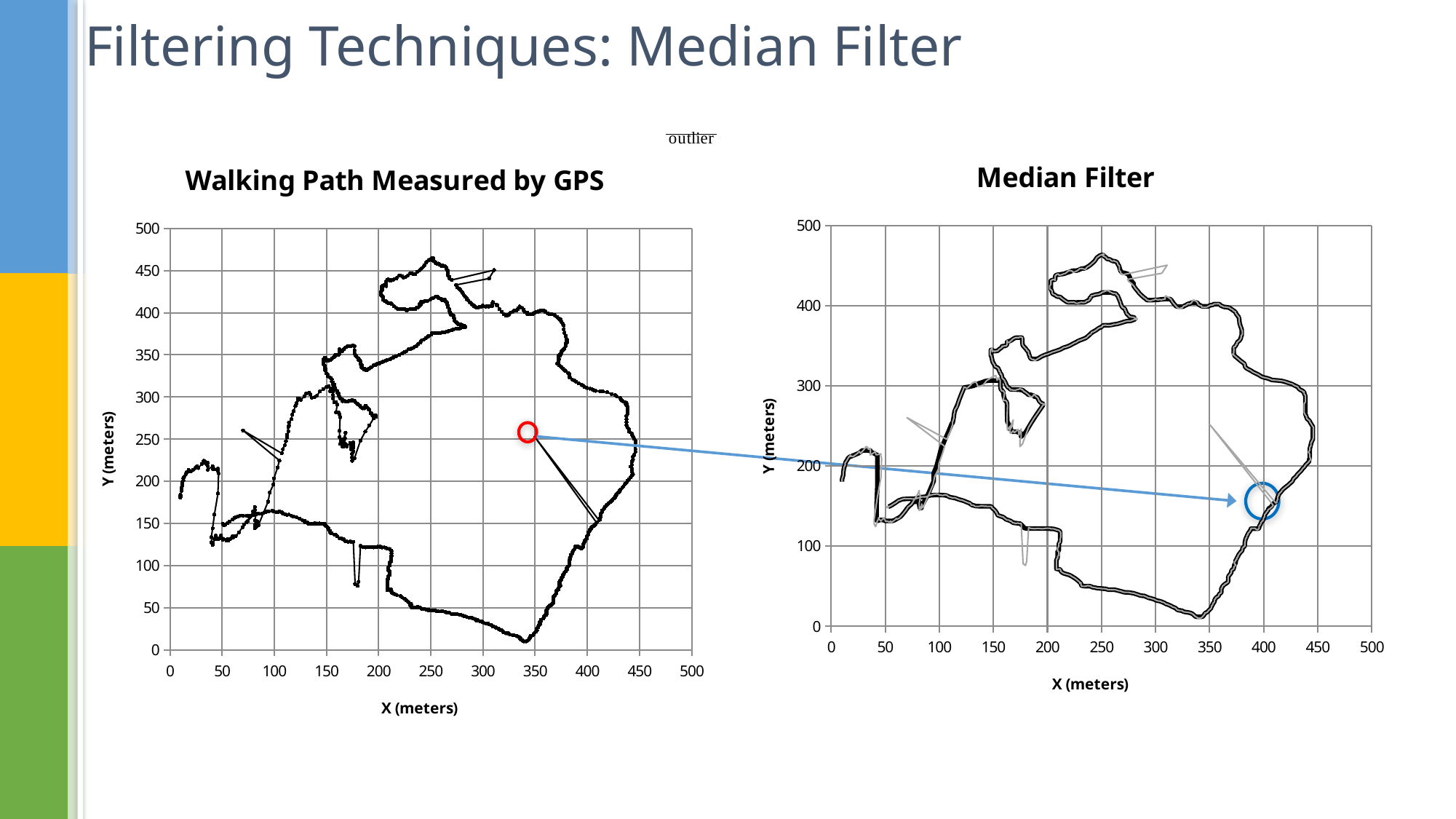
In the 'Walking Path Measured by GPS' chart, is the Y value of the downward spike near X = 180 greater or less than 100? less In the 'Walking Path Measured by GPS' chart, is the lowest Y value reached by the path (near X = 340) greater or less than 50? less In the 'Median Filter' chart, is the largest X value reached by the path greater or less than 400? greater What kind of chart is the 'Walking Path Measured by GPS' chart? scatter chart What is the title of the chart on the left of the slide? Walking Path Measured by GPS What kind of chart is the 'Median Filter' chart? scatter chart What is the label of the vertical axis on the 'Median Filter' chart? Y (meters)